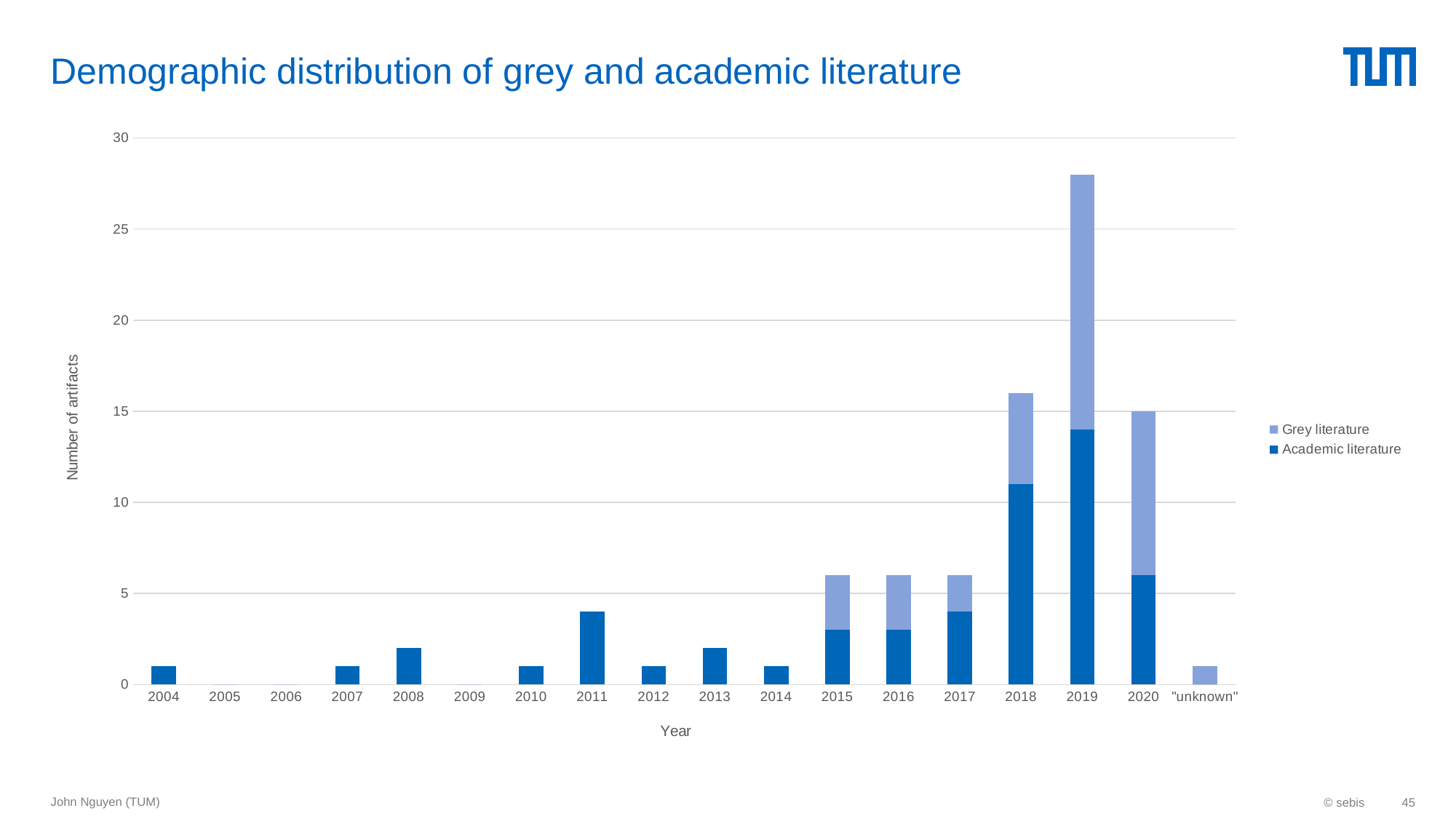
Which year has the highest total number of artifacts? 2019 Is the Academic literature value for 2019 greater or less than 15? less What is the label of the y axis? Number of artifacts How many categories are shown on the x axis? 18 What is the total number of artifacts for 2020? 15 What are the two series named in the legend? Grey literature and Academic literature Which has a larger total number of artifacts, 2018 or 2019? 2019 What kind of chart is shown on the slide? Stacked bar chart Is the total value for 2019 greater or less than 25? greater Is the total value for 2011 greater or less than 5? less How many series does the legend list? 2